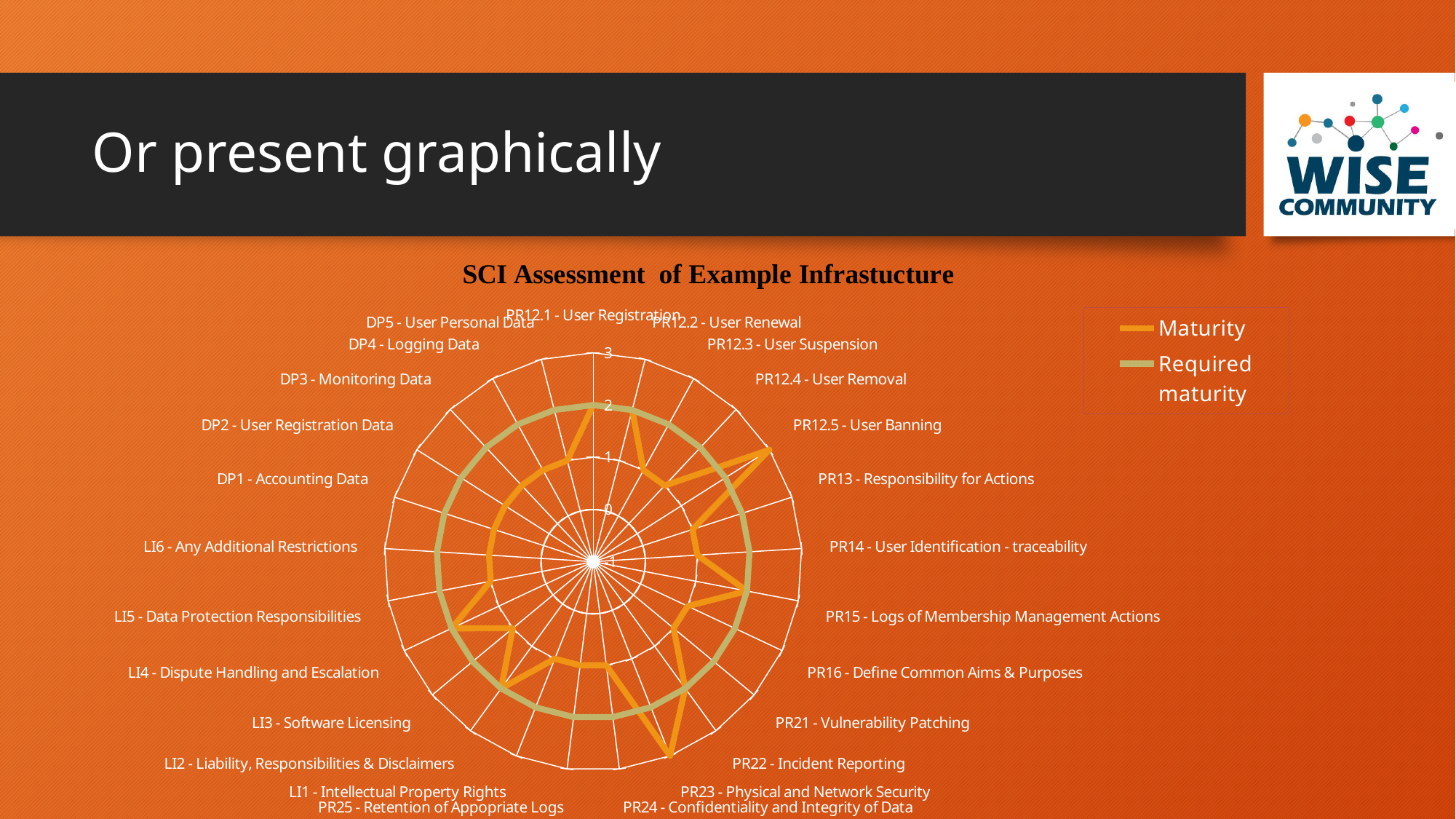
What is the Required maturity value for PR14 - User Identification - traceability? 2 Is the Maturity value for PR14 - User Identification - traceability greater or less than 2? less How many series does the chart legend list? 2 Which series is drawn in orange in the chart? Maturity What kind of chart is shown on the slide? Radar chart Which has the larger Maturity value, PR12.5 - User Banning or PR14 - User Identification - traceability? PR12.5 - User Banning How many categories are plotted around the radar chart? 25 What is the title of the chart? SCI Assessment of Example Infrastucture What is the Maturity value for PR22 - Incident Reporting? 2 Which has the larger Maturity value, PR22 - Incident Reporting or LI6 - Any Additional Restrictions? PR22 - Incident Reporting What is the Maturity value for PR12.5 - User Banning? 3